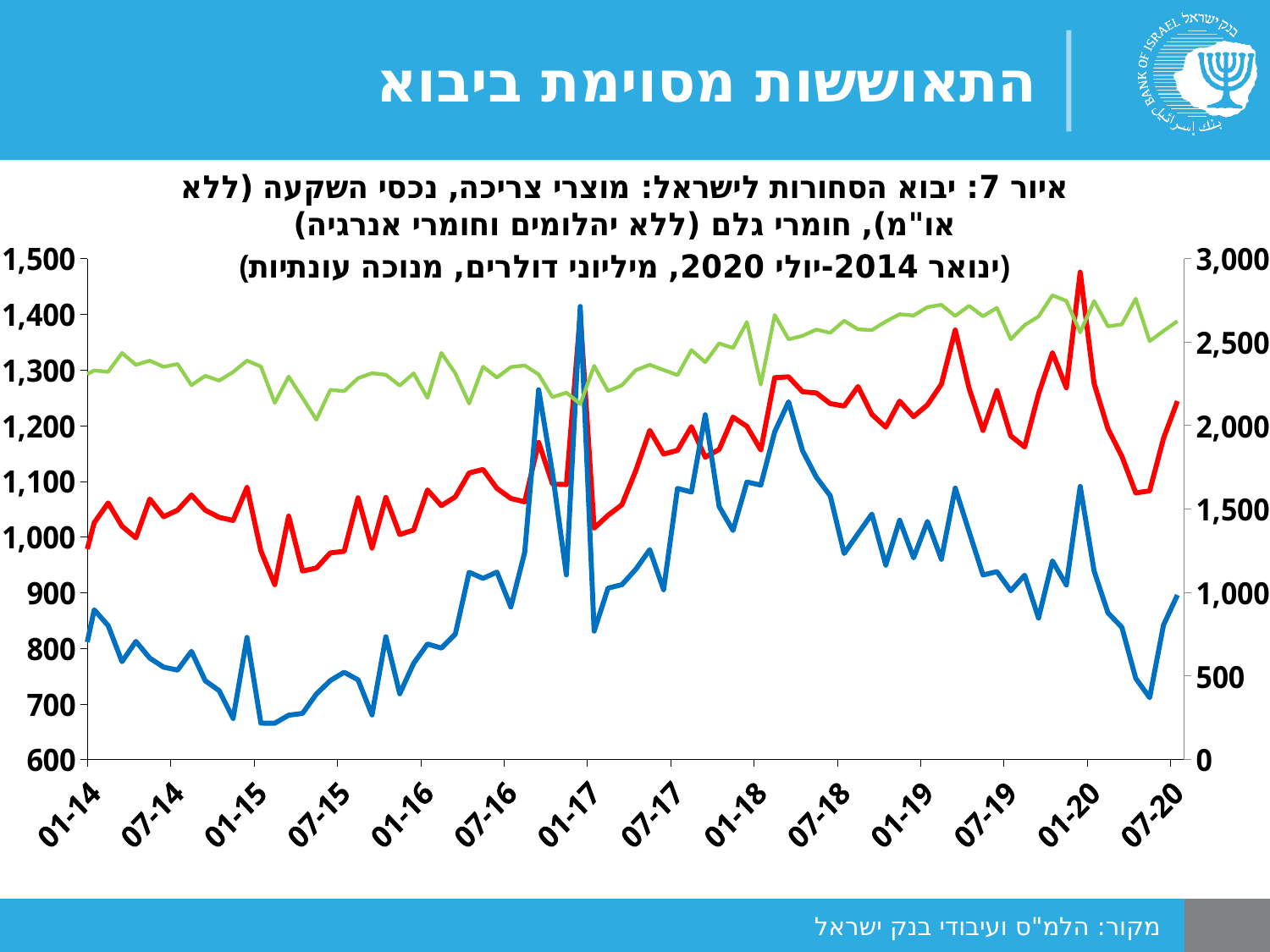
How many lines are plotted on the chart? 3 Read against the right-hand axis, is the green line at 01-20 greater or less than 2,500? greater Which coloured line lies below the other two for most of the chart? blue Does the green line generally rise or fall from 01-14 to 01-20? rise What is the last label on the x axis of the chart? 07-20 What type of chart is shown on the slide? line chart Which coloured line lies above the other two across the whole chart? green What is the highest value shown on the left-hand y axis? 1,500 Does the blue line generally rise or fall from 01-18 to 07-19? fall What is the first label on the x axis of the chart? 01-14 What is the highest value shown on the right-hand y axis? 3,000 How many tick labels are shown on the x axis? 14